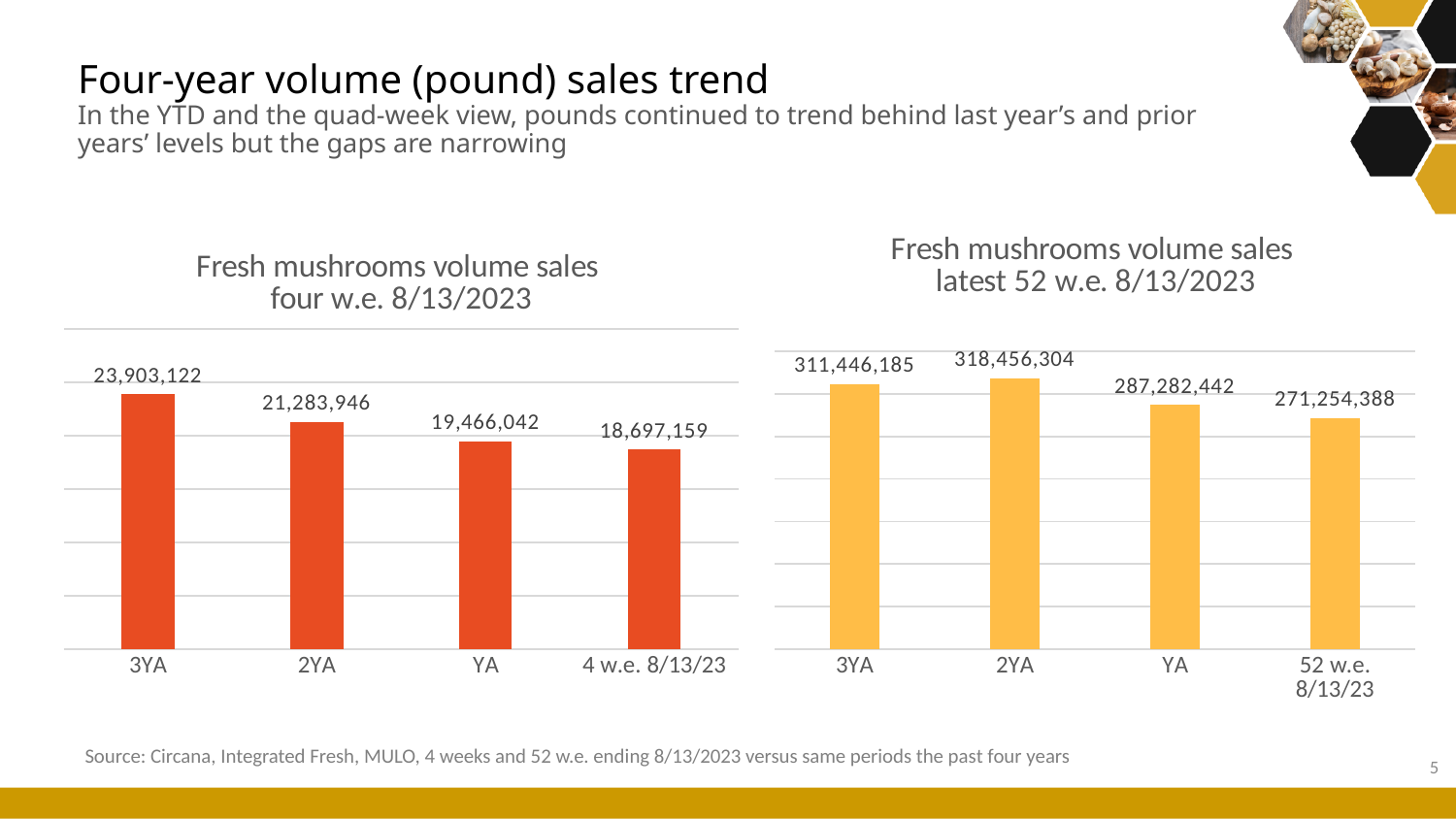
In the 'Fresh mushrooms volume sales latest 52 w.e. 8/13/2023' chart, what is the value for YA? 287,282,442 In the 'Fresh mushrooms volume sales four w.e. 8/13/2023' chart, do the values rise or fall from 3YA to 4 w.e. 8/13/23? Fall In the 'Fresh mushrooms volume sales latest 52 w.e. 8/13/2023' chart, what is the difference between the YA value and the 52 w.e. 8/13/23 value? 16,028,054 In the 'Fresh mushrooms volume sales latest 52 w.e. 8/13/2023' chart, which category has the highest value? 2YA In the 'Fresh mushrooms volume sales latest 52 w.e. 8/13/2023' chart, what is the value for 52 w.e. 8/13/23? 271,254,388 In the 'Fresh mushrooms volume sales four w.e. 8/13/2023' chart, which category has the lowest value? 4 w.e. 8/13/23 In the 'Fresh mushrooms volume sales four w.e. 8/13/2023' chart, what is the value for 4 w.e. 8/13/23? 18,697,159 In the 'Fresh mushrooms volume sales latest 52 w.e. 8/13/2023' chart, which is larger, the value for 3YA or the value for 2YA? 2YA What kind of chart is the 'Fresh mushrooms volume sales four w.e. 8/13/2023' chart? Bar chart In the 'Fresh mushrooms volume sales four w.e. 8/13/2023' chart, what is the value for 3YA? 23,903,122 How many categories are shown in the 'Fresh mushrooms volume sales four w.e. 8/13/2023' chart? 4 In the 'Fresh mushrooms volume sales four w.e. 8/13/2023' chart, what is the difference between the 3YA value and the 4 w.e. 8/13/23 value? 5,205,963